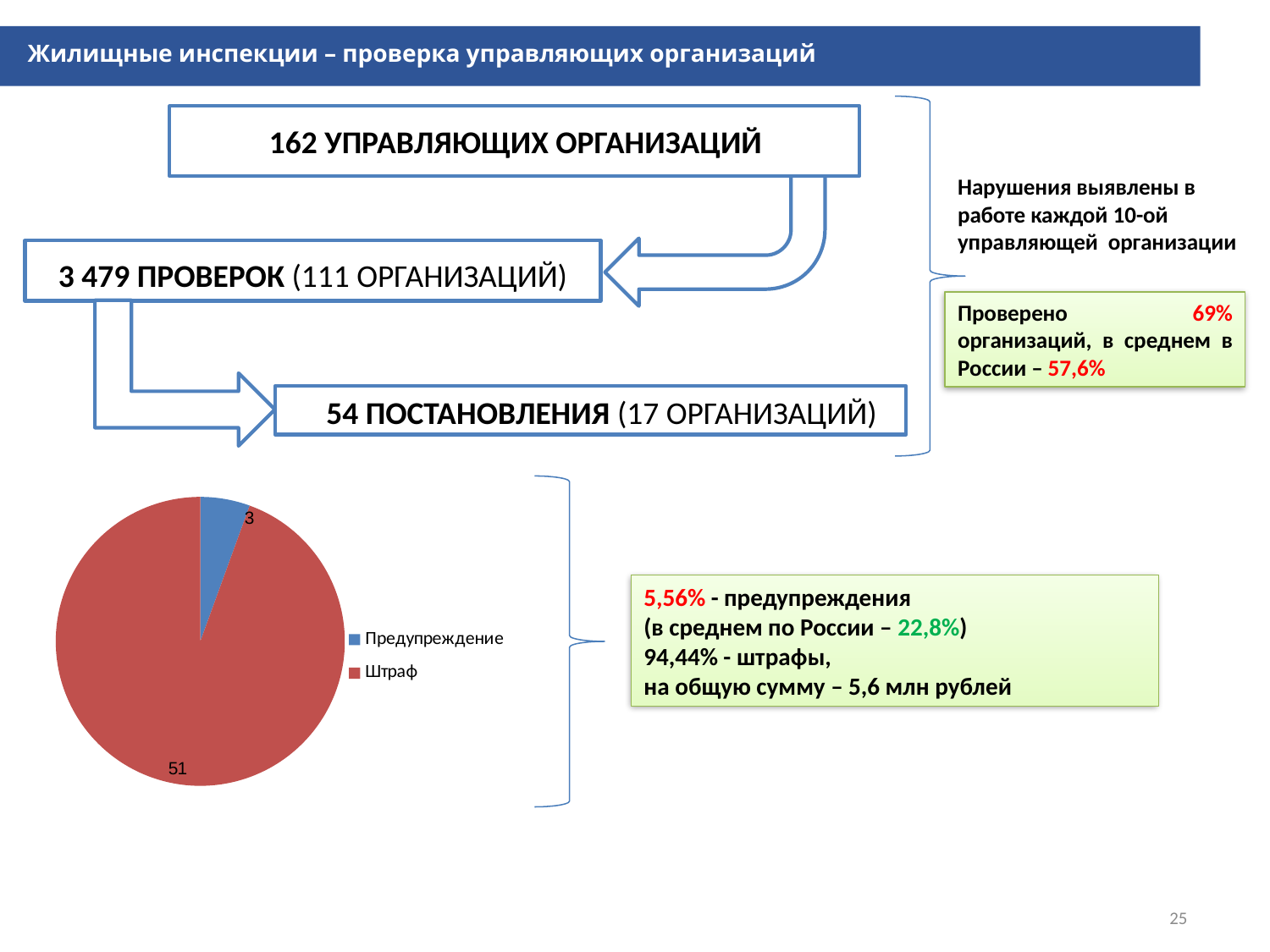
How many entries does the legend of the pie chart list? 2 What is the value for Штраф in the pie chart? 51 What is the difference between the values for Штраф and Предупреждение in the pie chart? 48 Which category has the smallest slice in the pie chart? Предупреждение What colour is the Штраф slice in the pie chart? red Which category has the largest slice in the pie chart? Штраф What share of the pie chart does Предупреждение represent? 5,56% What is the value for Предупреждение in the pie chart? 3 What is the total of all slices in the pie chart? 54 What type of chart is shown on the slide? pie chart How many categories does the pie chart have? 2 Which is larger in the pie chart, Штраф or Предупреждение? Штраф